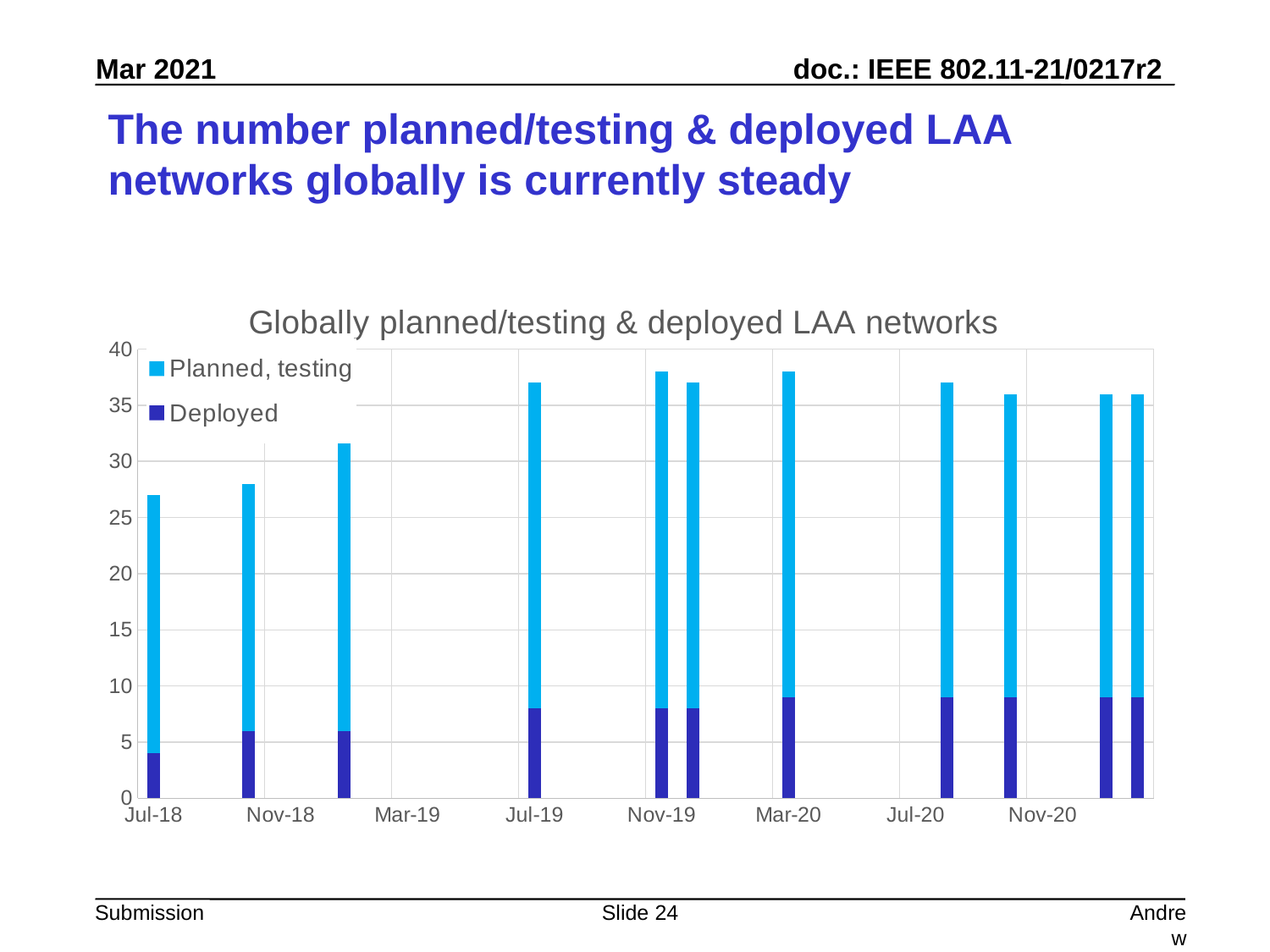
What kind of chart is shown on the slide? Stacked bar chart Which series is shown in dark blue at the bottom of each bar? Deployed Which bar is taller in total, Nov-18 or Jul-19? Jul-19 Is the Deployed value at Jul-18 greater or less than 5? less Do the total bar heights rise or fall from Jul-18 to Jul-19? rise Which bar has the lowest Deployed value? Jul-18 What is the title of the chart? Globally planned/testing & deployed LAA networks Is the total height of the bar at Jul-19 greater or less than 35? greater How many series does the legend list? 2 Is the Deployed value at Mar-20 greater or less than 10? less